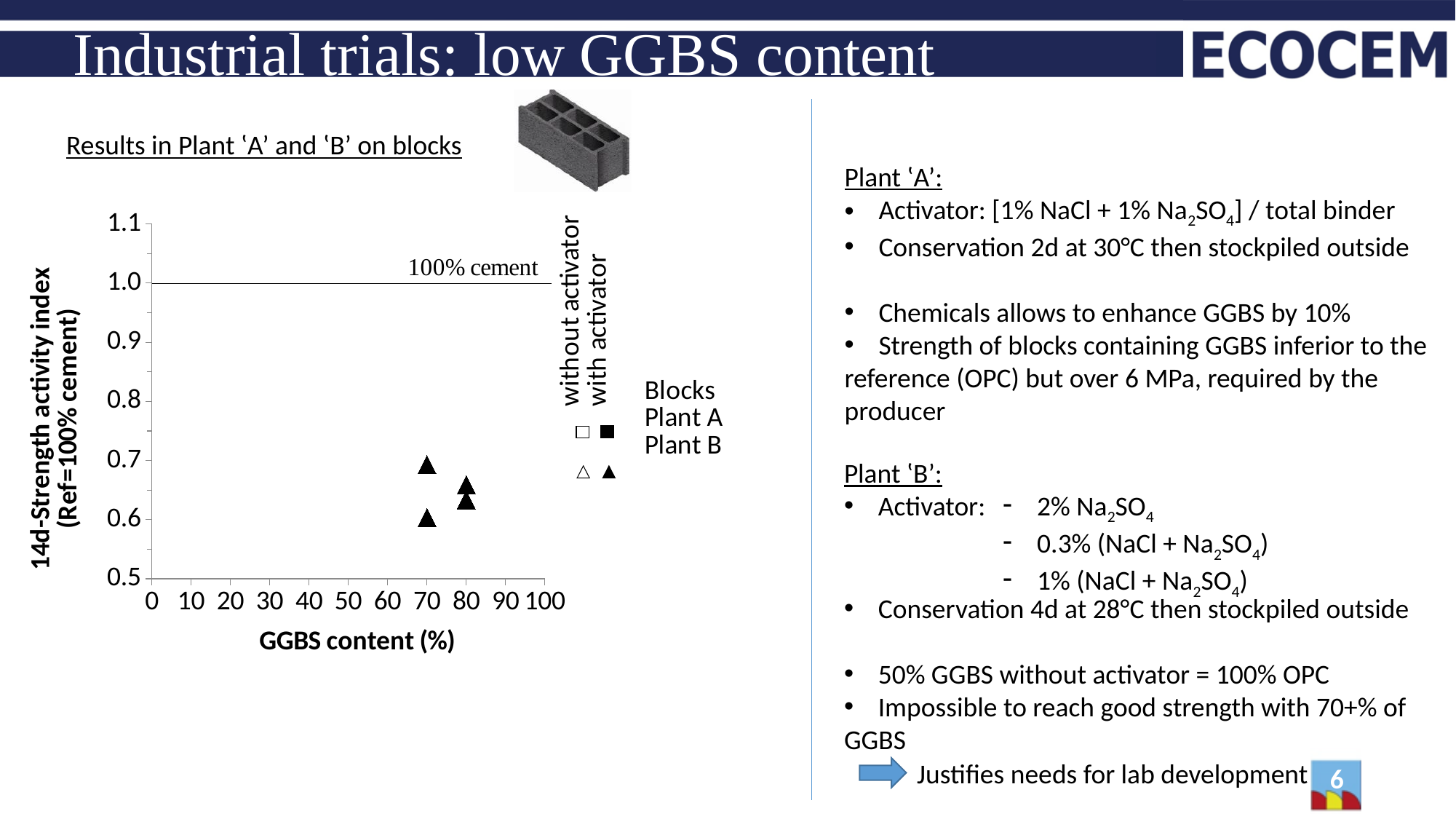
Are the plotted data points above or below the 100% cement reference line? below At what strength activity index value is the horizontal reference line labelled '100% cement' drawn? 1.0 At which GGBS content values are data points plotted? 70 and 80 Is the highest plotted point at 70% GGBS greater or less than 0.8? less Is the lowest plotted point at 70% GGBS greater or less than 0.5? greater Is the highest plotted data point greater or less than 1.0? less What is the label of the x axis of the chart? GGBS content (%) What kind of chart is shown on the slide? scatter plot What is the label of the y axis of the chart? 14d-Strength activity index (Ref=100% cement) How many data points are plotted on the chart? 4 Which plant do the filled triangle markers represent according to the legend? Plant B